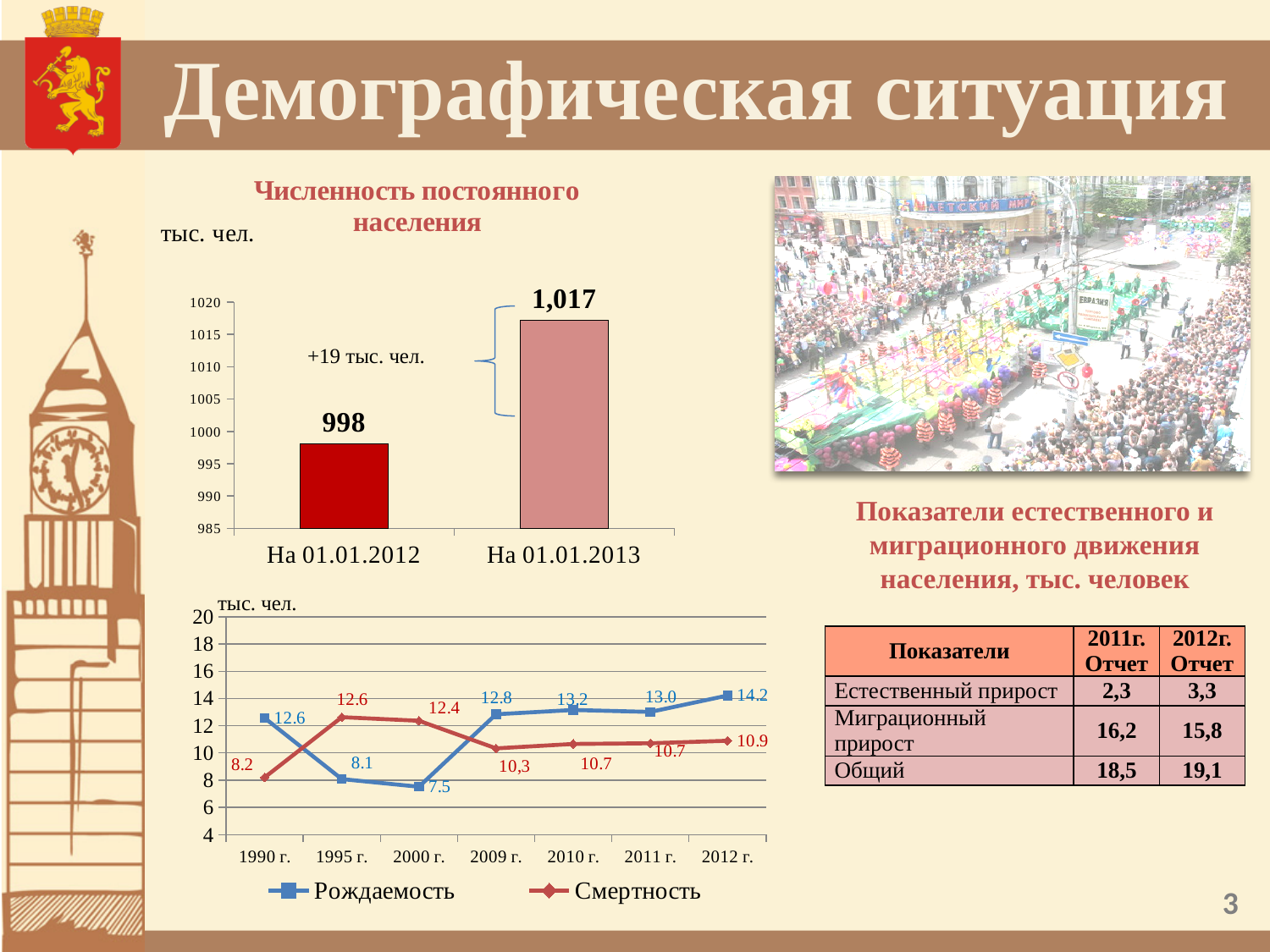
In the bar chart 'Численность постоянного населения', what is the difference between the values for На 01.01.2013 and На 01.01.2012? 19 In the bar chart 'Численность постоянного населения', which category has the higher value? На 01.01.2013 In the bar chart 'Численность постоянного населения', what is the value for На 01.01.2012? 998 In the line chart at the bottom left, what is the value of Рождаемость for 2012 г.? 14.2 What kind of chart is 'Численность постоянного населения'? bar chart In the bar chart 'Численность постоянного населения', what is the value for На 01.01.2013? 1,017 In the line chart at the bottom left, in which year is Рождаемость lowest? 2000 г. In the line chart at the bottom left, what is the difference between Рождаемость and Смертность in 2010 г.? 2.5 In the line chart at the bottom left, what is the value of Смертность for 1995 г.? 12.6 In the line chart at the bottom left, which is larger in 2012 г., Рождаемость or Смертность? Рождаемость In the line chart at the bottom left, how many series does the legend list? 2 In the line chart at the bottom left, how many years are shown on the x axis? 7